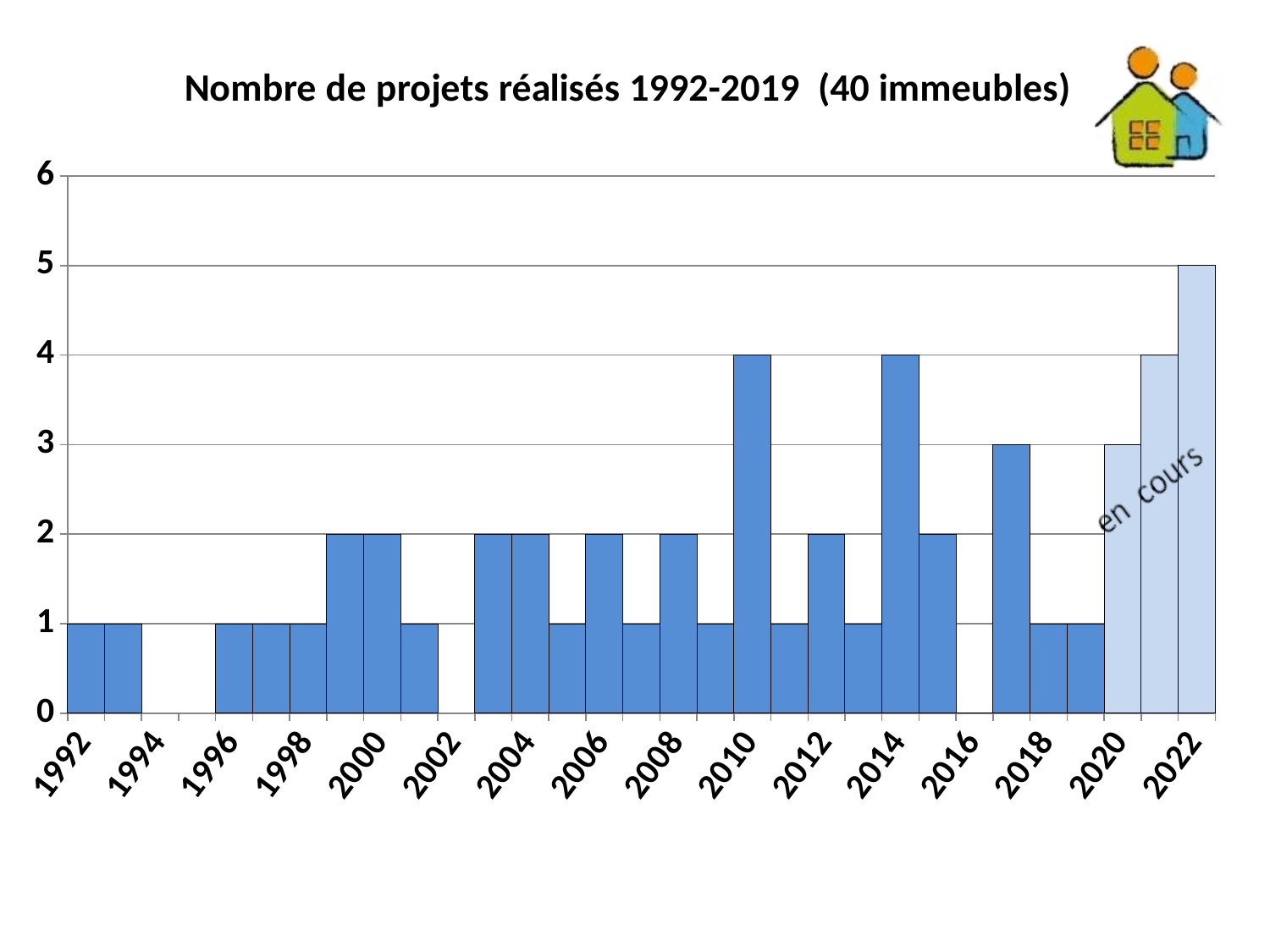
What is the value for 2010? 4 What is the value for 2022? 5 What is the value for 2016? 0 Which is larger, the value for 2010 or the value for 2012? 2010 What is the title of the chart? Nombre de projets réalisés 1992-2019 (40 immeubles) What label is written over the lighter bars at the right of the chart? en cours What kind of chart is this? bar chart How many years have a value of 4? 3 What is the difference between the values for 2014 and 2018? 3 Do the values rise or fall from 2020 to 2022? rise Which year has the highest bar? 2022 What is the value for 2017? 3